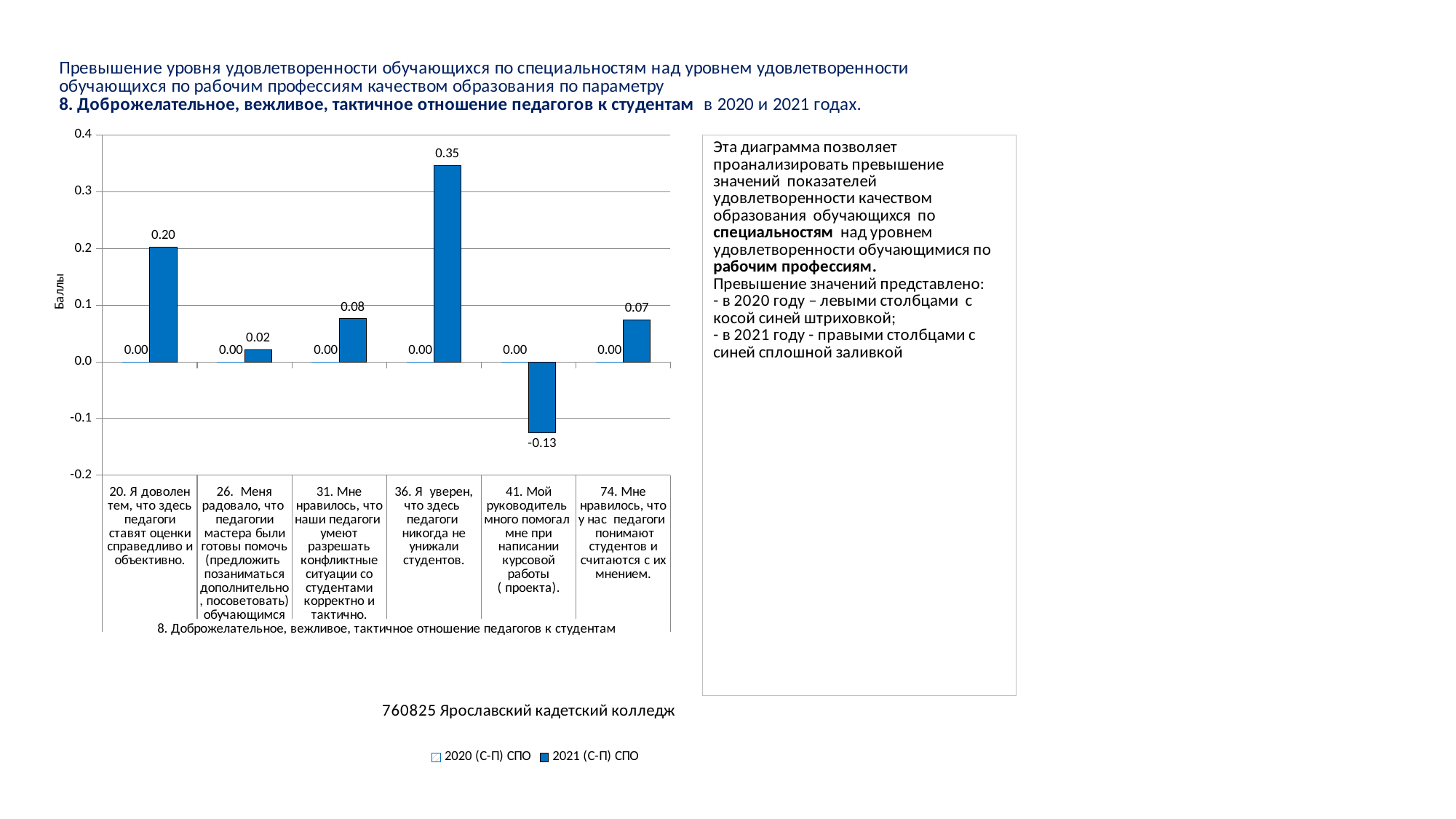
Which category has the lowest 2021 (С-П) СПО value? 41. Мой руководитель много помогал мне при написании курсовой работы (проекта). What is the 2020 (С-П) СПО value for category 74 (Мне нравилось, что у нас педагоги понимают студентов и считаются с их мнением)? 0.00 Which is larger for 2021 (С-П) СПО: the value for category 31 or the value for category 74? Category 31 (0.08) What is the 2021 (С-П) СПО value for category 20 (Я доволен тем, что здесь педагоги ставят оценки справедливо и объективно)? 0.20 What type of chart is shown on the slide? Bar chart What is the label of the vertical axis of the chart? Баллы What is the 2021 (С-П) СПО value for category 41 (Мой руководитель много помогал мне при написании курсовой работы)? -0.13 How many series does the chart legend list? 2 What is the difference between the 2021 (С-П) СПО values for category 36 and category 20? 0.15 What is the 2021 (С-П) СПО value for category 36 (Я уверен, что здесь педагоги никогда не унижали студентов)? 0.35 Which category has the highest 2021 (С-П) СПО value? 36. Я уверен, что здесь педагоги никогда не унижали студентов. How many categories are shown on the x axis of the chart? 6